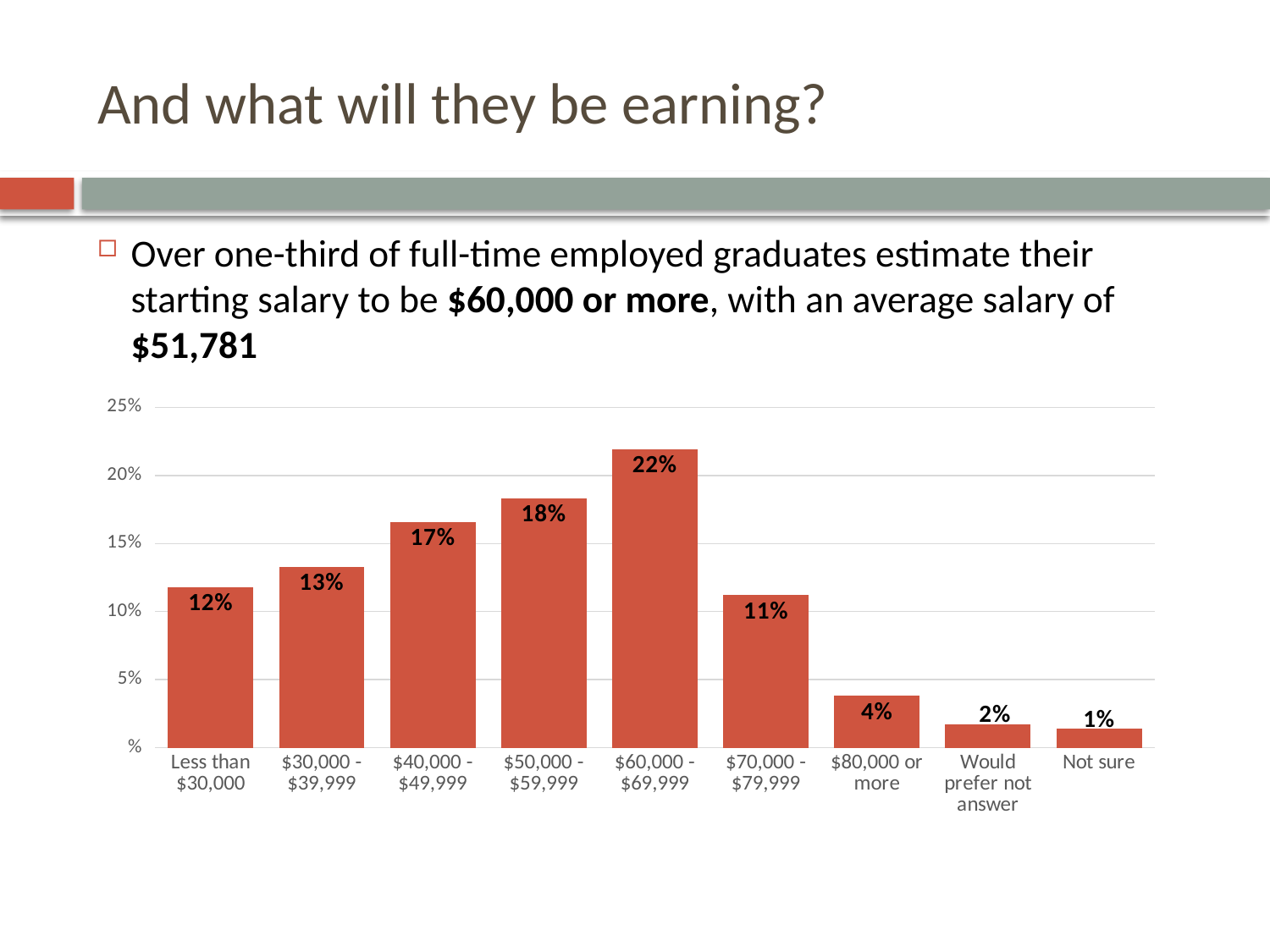
What percentage of graduates estimate a starting salary of $60,000 - $69,999? 22% Is the value for $50,000 - $59,999 greater or less than 15%? greater How many categories are shown on the x axis of the chart? 9 What is the value for the 'Would prefer not answer' category? 2% Which salary category has the highest percentage? $60,000 - $69,999 What is the highest value shown on the chart's y axis? 25% Which is larger: the value for $40,000 - $49,999 or the value for $30,000 - $39,999? $40,000 - $49,999 What is the difference in percentage points between the $60,000 - $69,999 and $70,000 - $79,999 categories? 11 Do the values rise or fall from the $60,000 - $69,999 category to the Not sure category? fall Which category has the lowest percentage? Not sure What percentage of graduates estimate a starting salary of less than $30,000? 12% What kind of chart is shown on the slide? bar chart